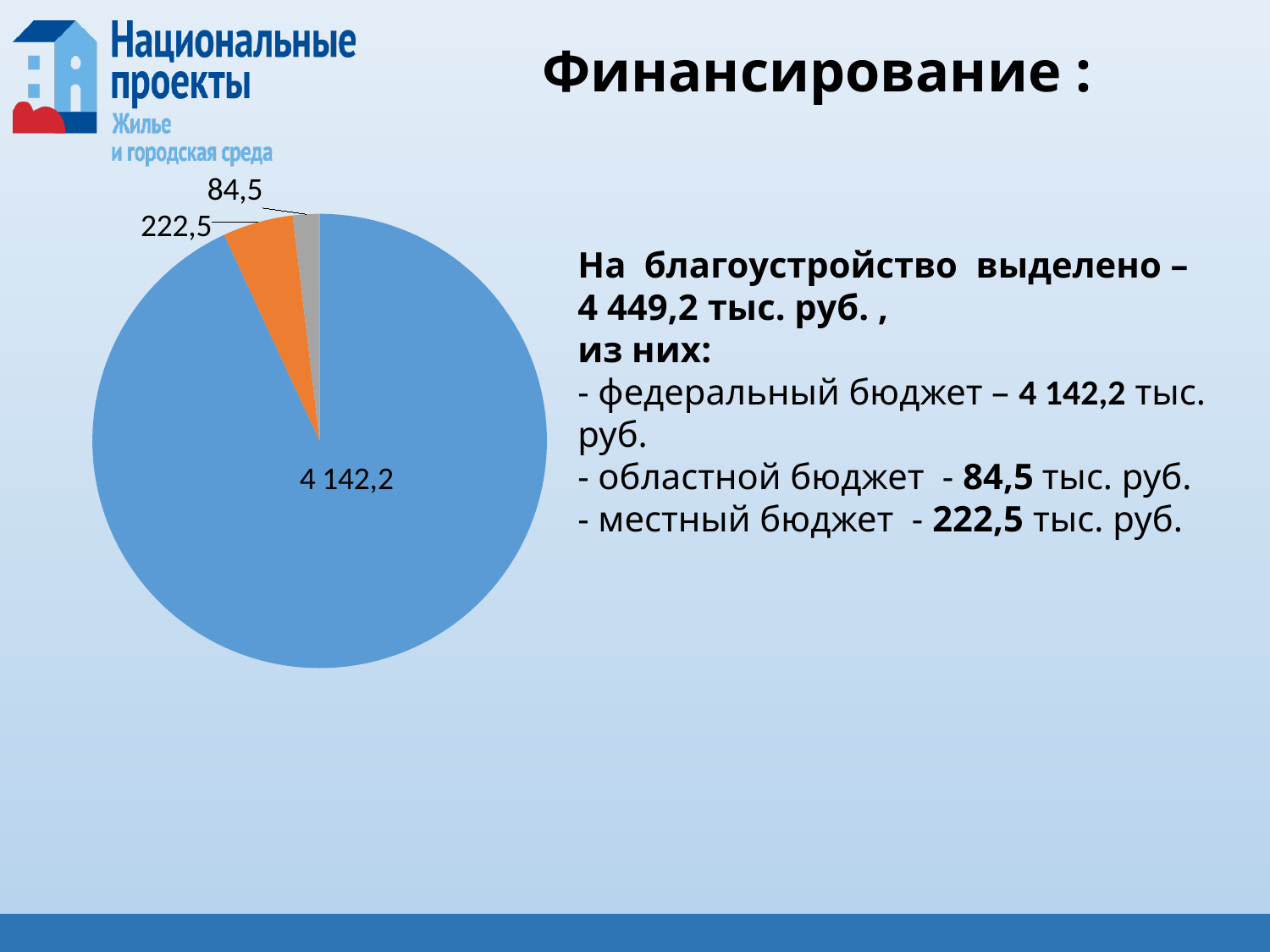
Which slice is larger, the orange slice or the grey slice? the orange slice What value is labelled on the grey slice of the pie chart? 84,5 What is the value of the smallest slice of the pie chart? 84,5 What is the total of all three slices in the pie chart? 4 449,2 What is the difference between the orange slice (222,5) and the grey slice (84,5)? 138 What is the difference between the largest slice (4 142,2) and the orange slice (222,5)? 3 919,7 How many slices does the pie chart have? 3 What value is labelled on the orange slice of the pie chart? 222,5 What is the value of the largest slice of the pie chart? 4 142,2 What share of the pie does the largest slice (4 142,2) represent? 93,1% What type of chart is shown on the slide? pie chart What colour is the largest slice of the pie chart? blue